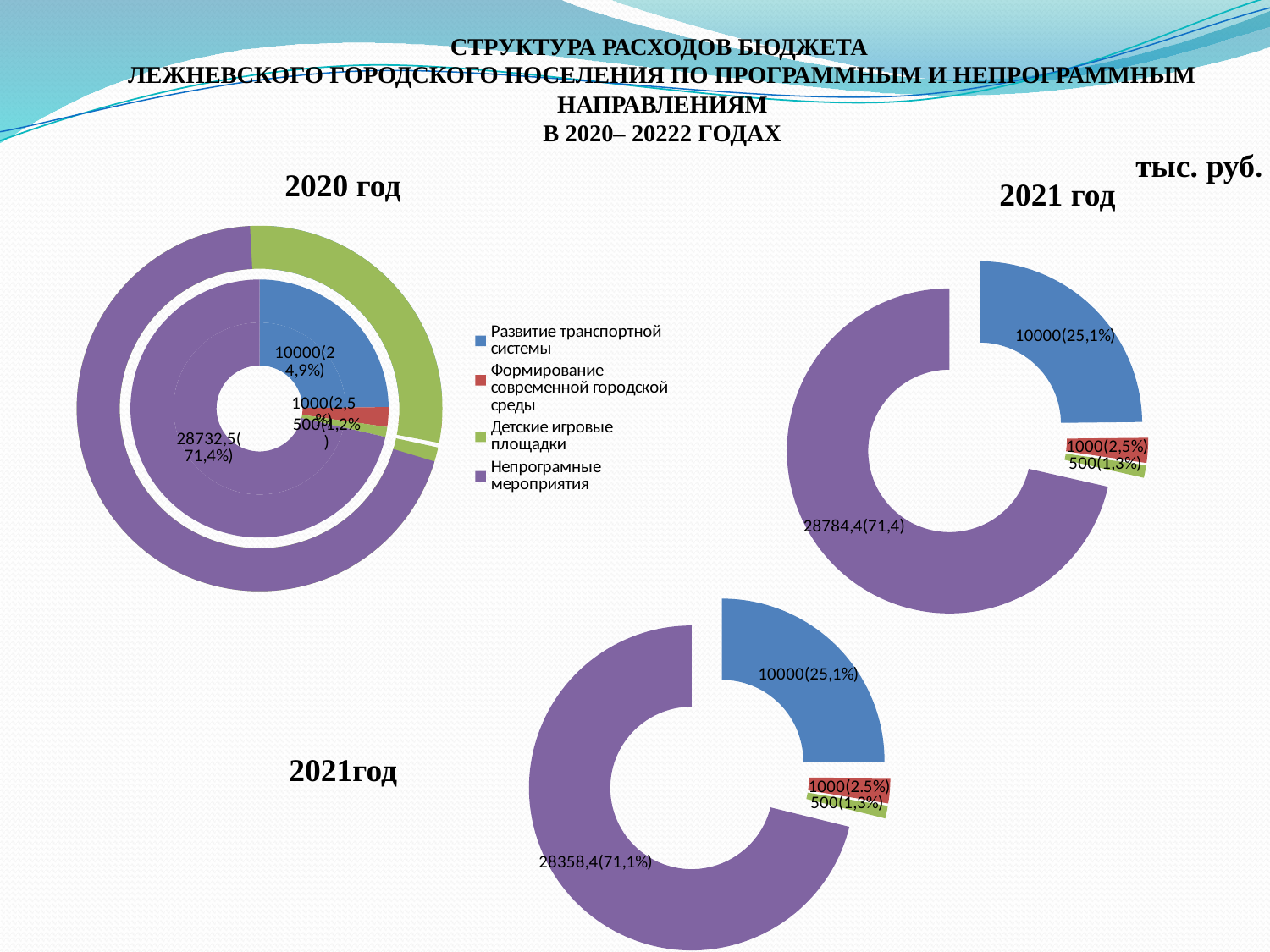
In the bottom chart titled 2021год, which category has the smallest share? Детские игровые площадки In the chart titled 2020 год, what is the difference between the value for Развитие транспортной системы and the value for Формирование современной городской среды? 9000 In the chart titled 2020 год, what share of the total does Развитие транспортной системы account for? 24,9% Which colour represents Непрограмные мероприятия in the legend? Purple In the bottom chart titled 2021год, which is larger: the value for Формирование современной городской среды or the value for Детские игровые площадки? Формирование современной городской среды In the bottom chart titled 2021год, what value is labelled for the Непрограмные мероприятия segment? 28358,4(71,1%) In the chart titled 2021 год at the top right, what value is labelled for the Развитие транспортной системы segment? 10000(25,1%) In the chart titled 2020 год, what value is labelled for the Непрограмные мероприятия segment? 28732,5(71,4%) In the chart titled 2020 год, which category has the largest share? Непрограмные мероприятия In the chart titled 2021 год at the top right, what share does Детские игровые площадки account for? 1,3% How many entries does the legend on the slide list? 4 What kind of chart is the chart titled 2020 год? Doughnut chart